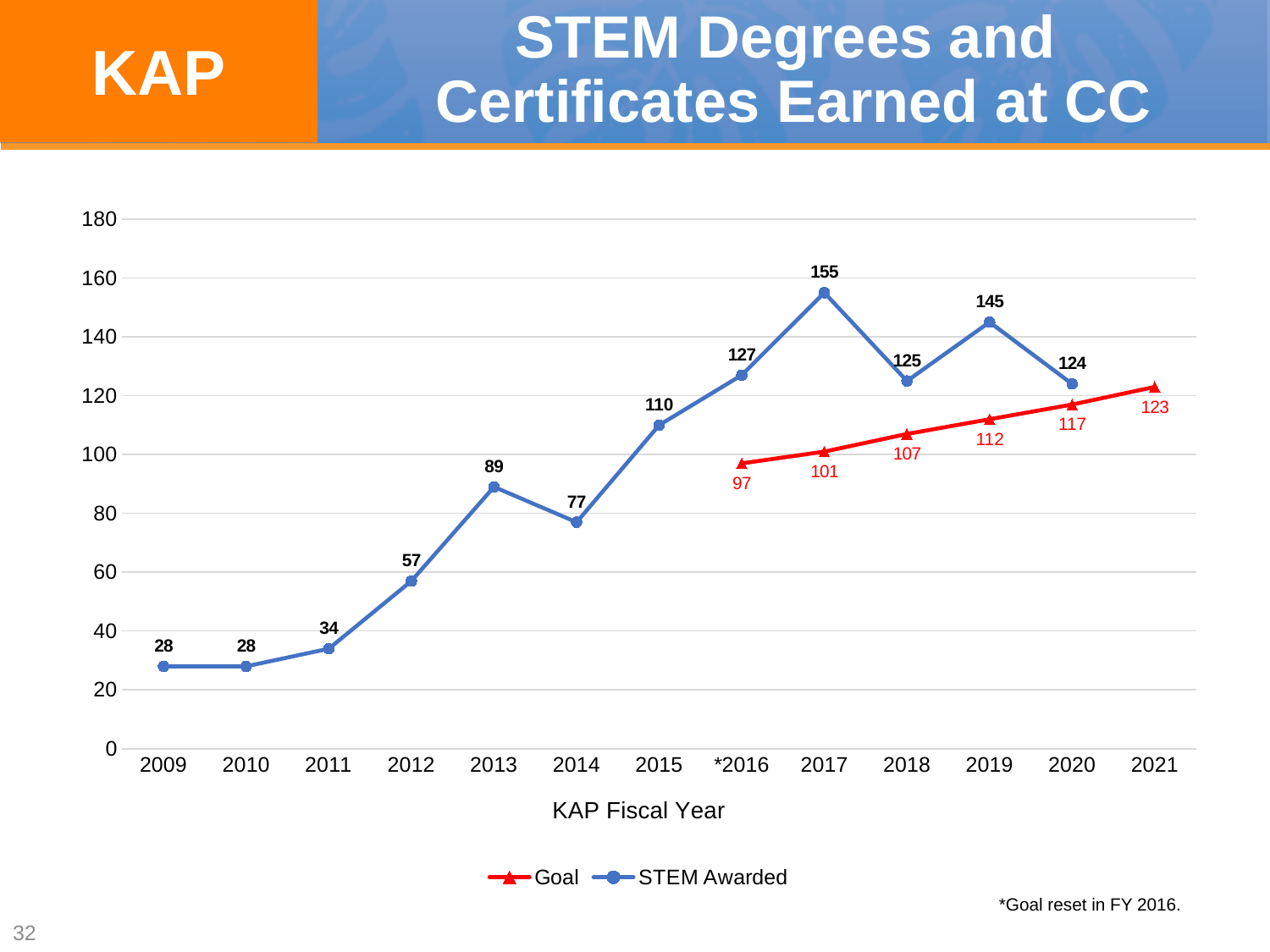
How many fiscal years are shown on the x axis? 13 What was the STEM Awarded value in 2017? 155 Which was larger in 2018, the STEM Awarded value or the Goal value? STEM Awarded What is the lowest STEM Awarded value shown on the chart? 28 What kind of chart is shown on the slide? Line chart What was the Goal value for 2019? 112 What is the label of the x axis? KAP Fiscal Year How many series does the legend list? 2 What was the STEM Awarded value in 2013? 89 What is the difference between the STEM Awarded value and the Goal value in 2020? 7 Does the Goal series rise or fall from 2016 to 2021? Rise In which year was the STEM Awarded value highest? 2017